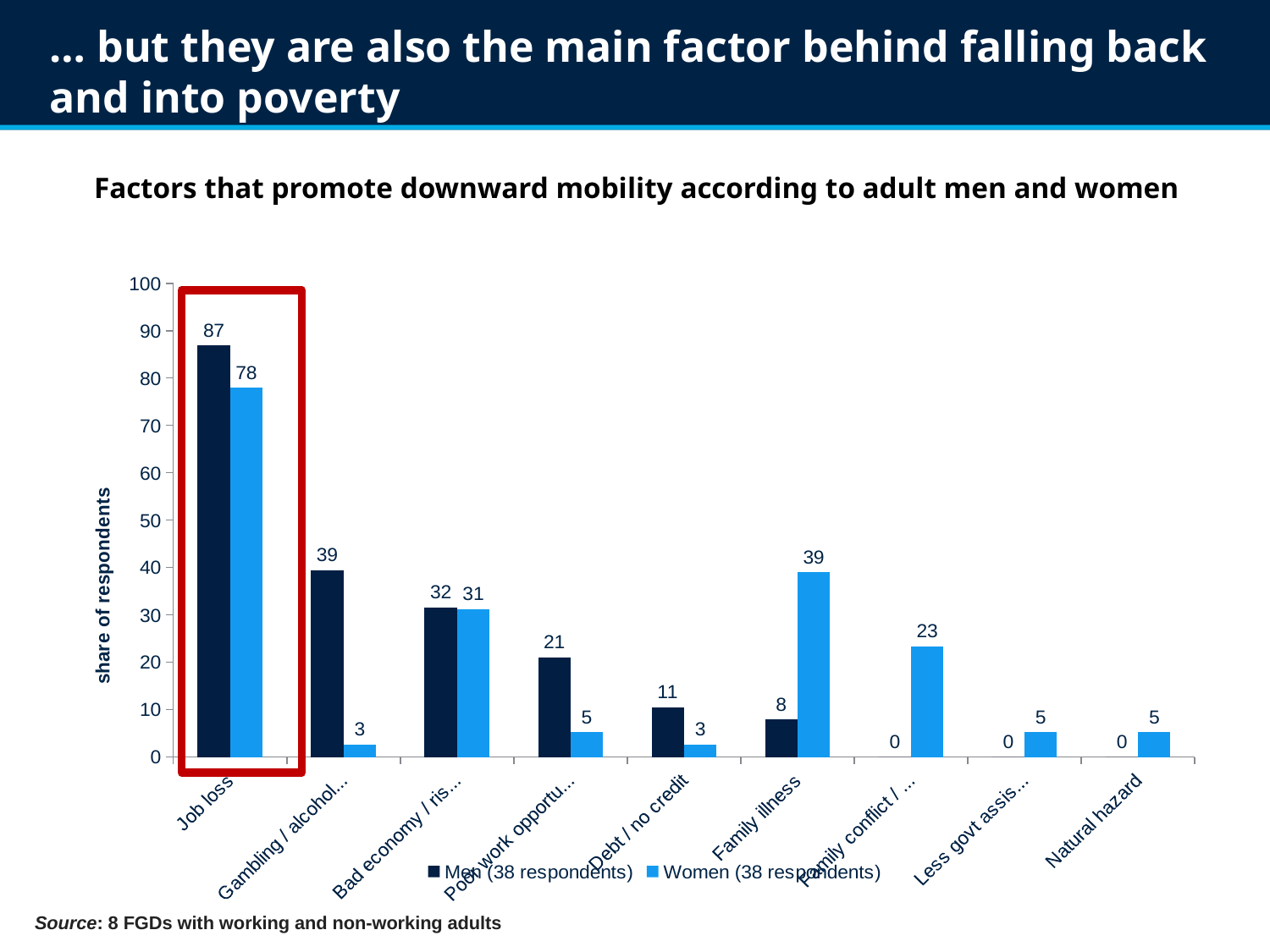
What is the value for Women for Natural hazard? 5 For Debt / no credit, which is larger: the value for Men or for Women? Men What is the difference between the Women and Men values for Family illness? 31 Which category has the highest value for Men? Job loss What is the value for Men for Debt / no credit? 11 How many series does the legend list? 2 What is the value for Women for Family illness? 39 For Family illness, which is larger: the value for Men or for Women? Women What is the difference between the Men and Women values for Job loss? 9 What is the value for Men for Job loss? 87 Which category has the highest value for Women? Job loss How many categories are shown on the x axis? 9